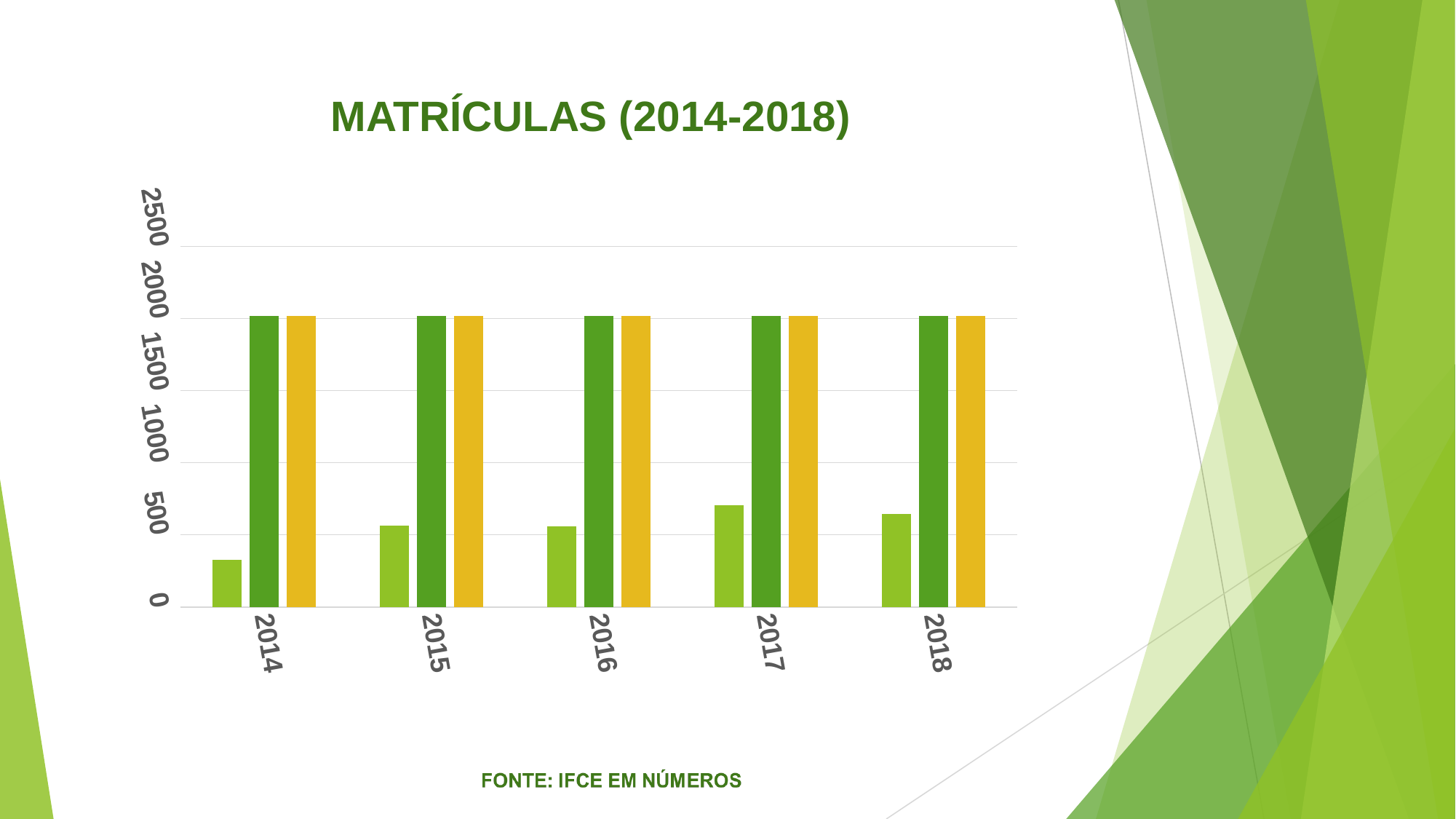
Is the value of the light green bar for 2014 greater or less than 500? less How many years are shown on the x axis of the chart? 5 How many bars are plotted for each year in the chart? 3 Which is larger, the light green bar for 2014 or the light green bar for 2017? 2017 What is the title of the chart? MATRÍCULAS (2014-2018) Which year has the highest light green bar? 2017 Is the value of the dark green bar for 2016 greater or less than 1500? greater Is the value of the light green bar for 2018 greater or less than 1000? less What kind of chart is shown on the slide? bar chart Which year has the lowest light green bar? 2014